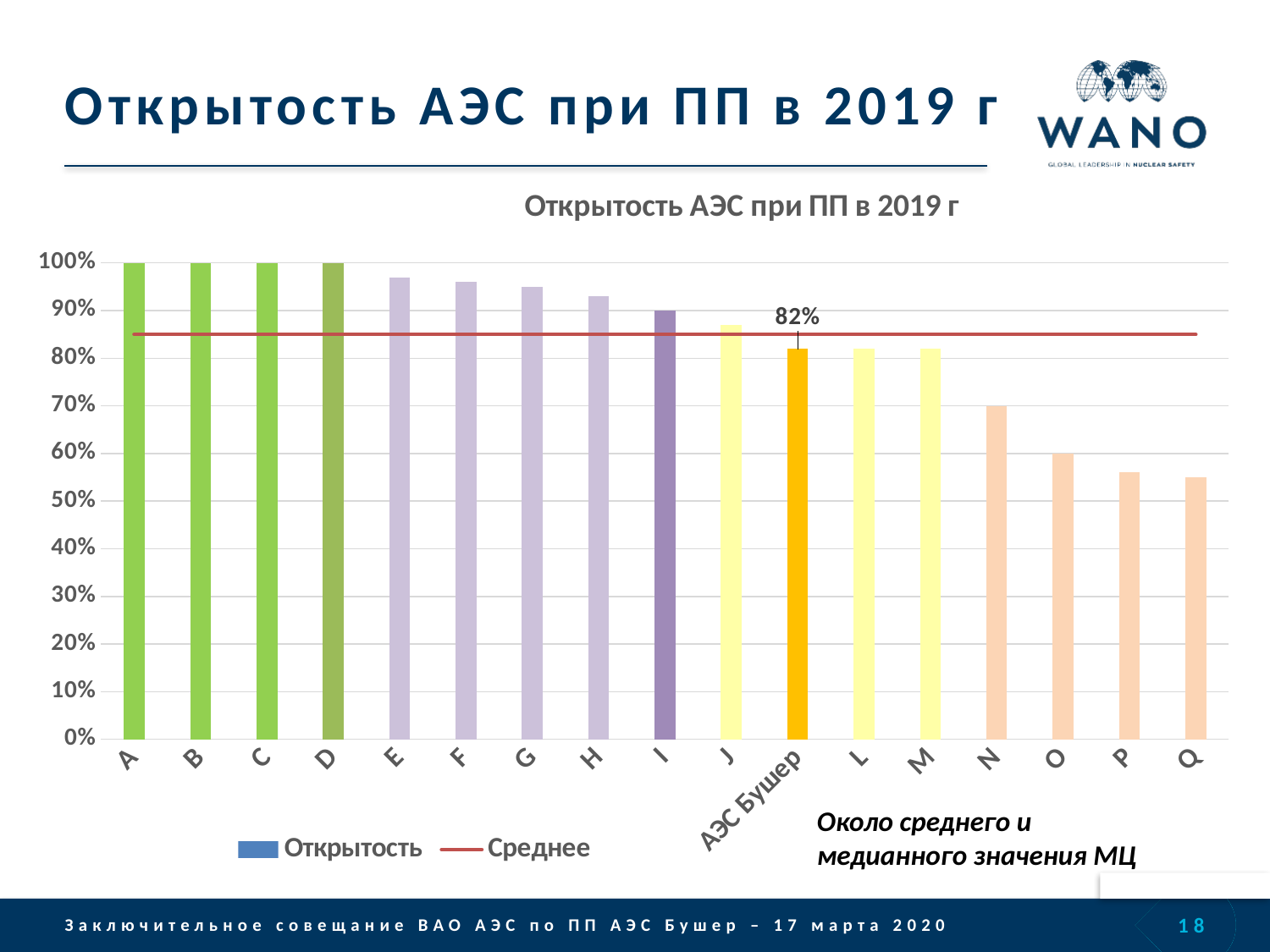
Is the value for Q greater or less than 60%? less What is the difference between the value for A and the value for АЭС Бушер? 18% How many categories are shown on the x axis? 17 What is the value for N? 70% What is the value for АЭС Бушер? 82% Is the value for E greater or less than 90%? greater How many entries does the legend list? 2 Do the bar values rise or fall from left to right along the x axis? fall What is the value for I? 90% Which is larger, the value for N or the value for O? N What is the value for A? 100% What is the value for O? 60%